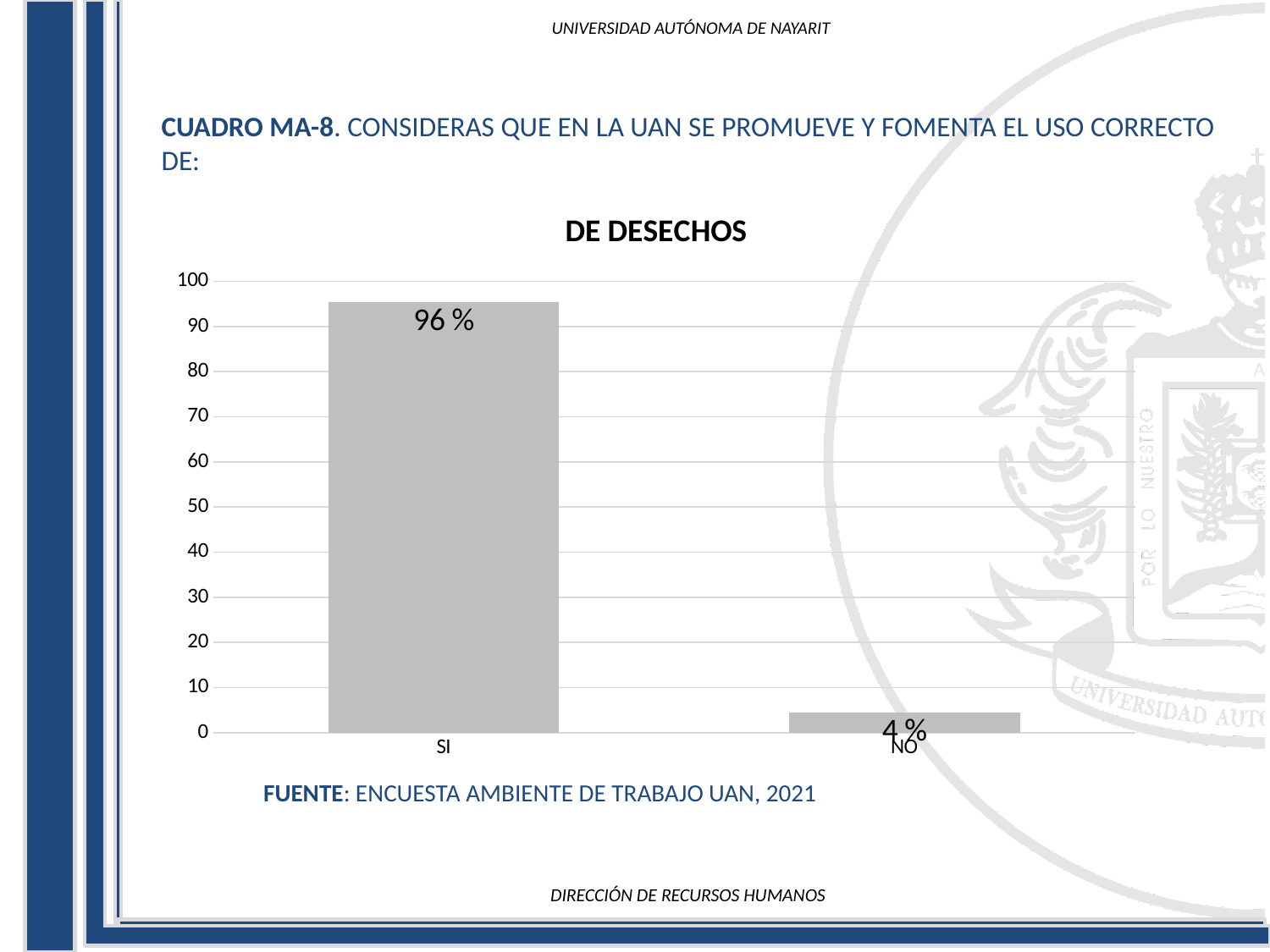
What kind of chart is shown? bar chart Is the value for SI greater or less than 90? greater What is the value for SI? 96 % Which category has the highest value? SI What is the title of the chart? DE DESECHOS What is the difference between the values for SI and NO? 92 % What is the value for NO? 4 % Which is larger, the value for SI or the value for NO? SI How many categories are shown on the x axis? 2 Which category has the lowest value? NO Is the value for NO greater or less than 10? less What is the highest value shown on the y axis? 100